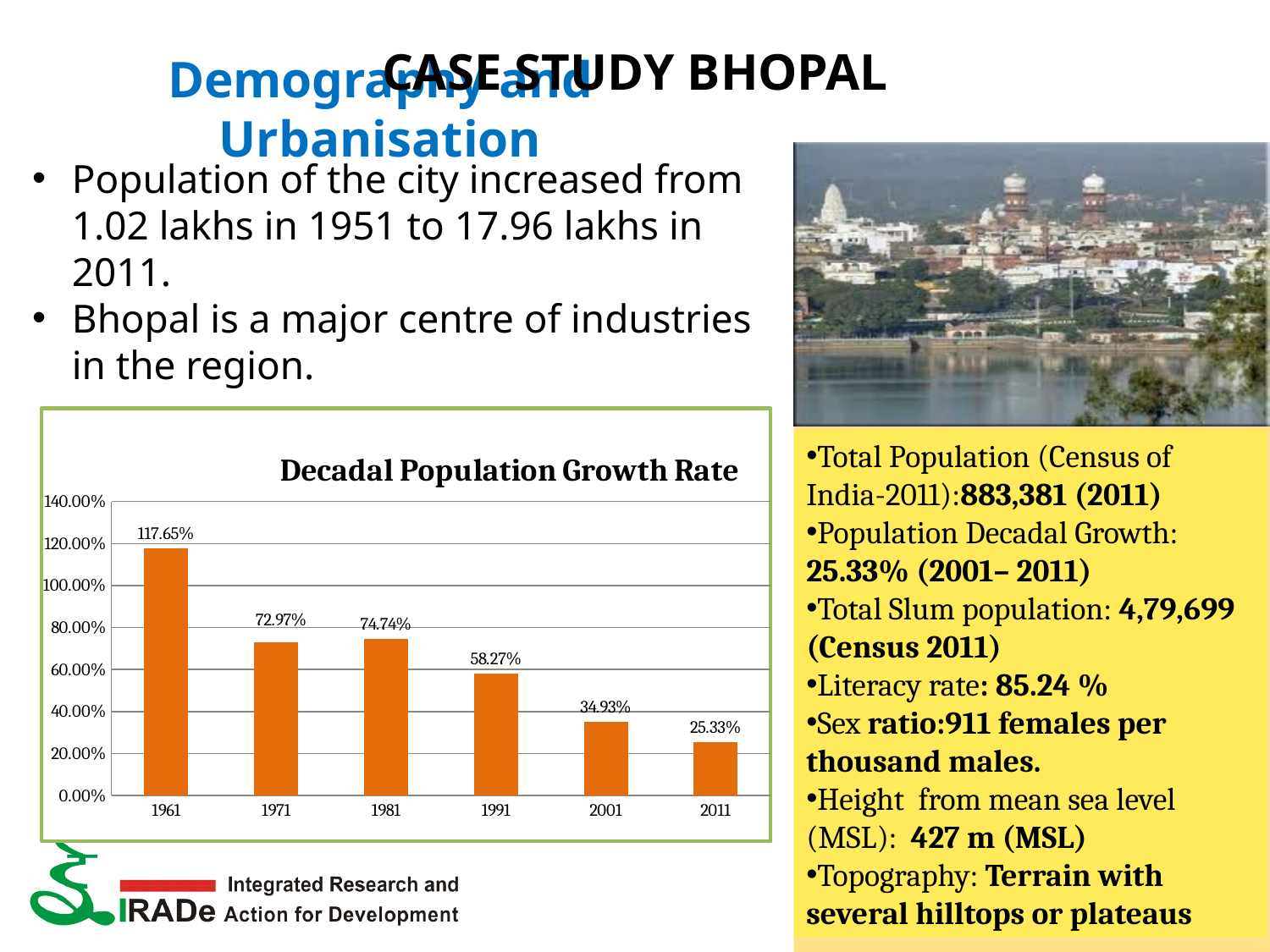
What kind of chart is used to show the decadal population growth rate? bar chart What is the title of the chart? Decadal Population Growth Rate How many years are shown on the x axis of the chart? 6 Which year has a higher growth rate, 1981 or 1991? 1981 Do the growth rates generally rise or fall from 1961 to 2011? fall What is the decadal population growth rate shown for 2011? 25.33% Which year has the highest decadal population growth rate? 1961 What is the decadal population growth rate shown for 1961? 117.65% Which year has the lowest decadal population growth rate? 2011 What is the difference between the growth rates for 1961 and 1971? 44.68% Is the value for 2001 greater or less than 40.00%? less What is the decadal population growth rate shown for 1991? 58.27%